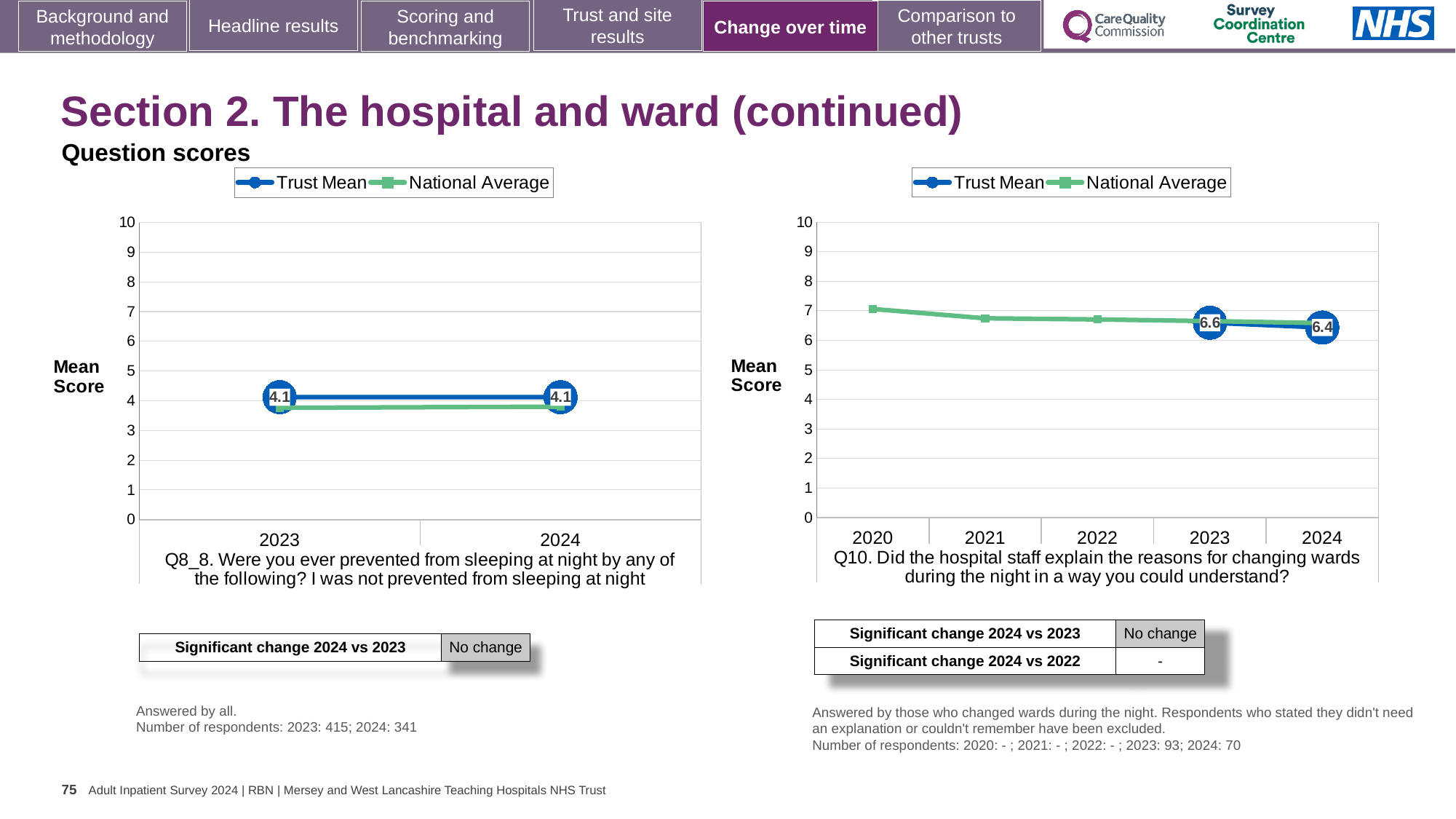
In the right chart (Q10), what is the Trust Mean for 2023? 6.6 In the left chart (Q8_8), which is higher in 2023, the Trust Mean or the National Average? Trust Mean In the right chart (Q10), what is the Trust Mean for 2024? 6.4 In the left chart (Q8_8), what is the Trust Mean for 2023? 4.1 In the right chart (Q10), is the National Average for 2020 greater or less than 6? greater What kind of chart is the right chart (Q10)? line chart In the right chart (Q10), did the Trust Mean rise or fall from 2023 to 2024? fall In the left chart (Q8_8), what is the Trust Mean for 2024? 4.1 How many years are shown on the x axis of the right chart (Q10)? 5 In the right chart (Q10), what is the difference between the Trust Mean for 2023 and 2024? 0.2 How many series does the legend of the left chart (Q8_8) list? 2 How many years are shown on the x axis of the left chart (Q8_8)? 2